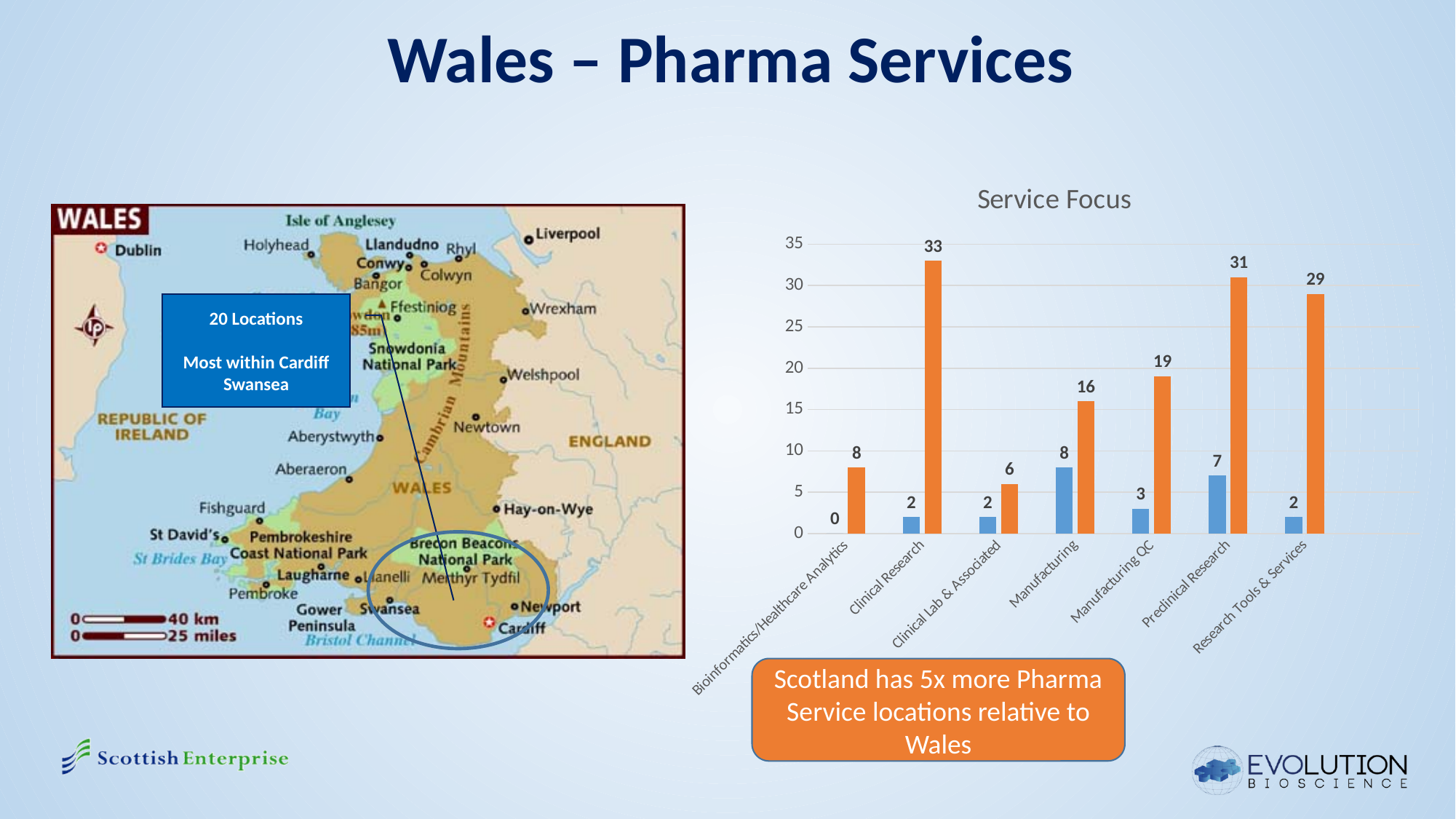
In the Service Focus chart, is the orange bar for Research Tools & Services larger or smaller than the orange bar for Manufacturing QC? larger What is the value of the orange bar for Clinical Research in the Service Focus chart? 33 What is the value of the orange bar for Manufacturing QC in the Service Focus chart? 19 What is the difference between the orange and blue bars for Preclinical Research in the Service Focus chart? 24 Which category has the highest orange bar in the Service Focus chart? Clinical Research Which category has the lowest orange bar in the Service Focus chart? Clinical Lab & Associated What is the title of the chart on the right of the slide? Service Focus Which category has the highest blue bar in the Service Focus chart? Manufacturing What is the value of the blue bar for Bioinformatics/Healthcare Analytics in the Service Focus chart? 0 How many categories are shown on the x axis of the Service Focus chart? 7 What is the value of the blue bar for Manufacturing in the Service Focus chart? 8 What type of chart is the Service Focus chart? bar chart